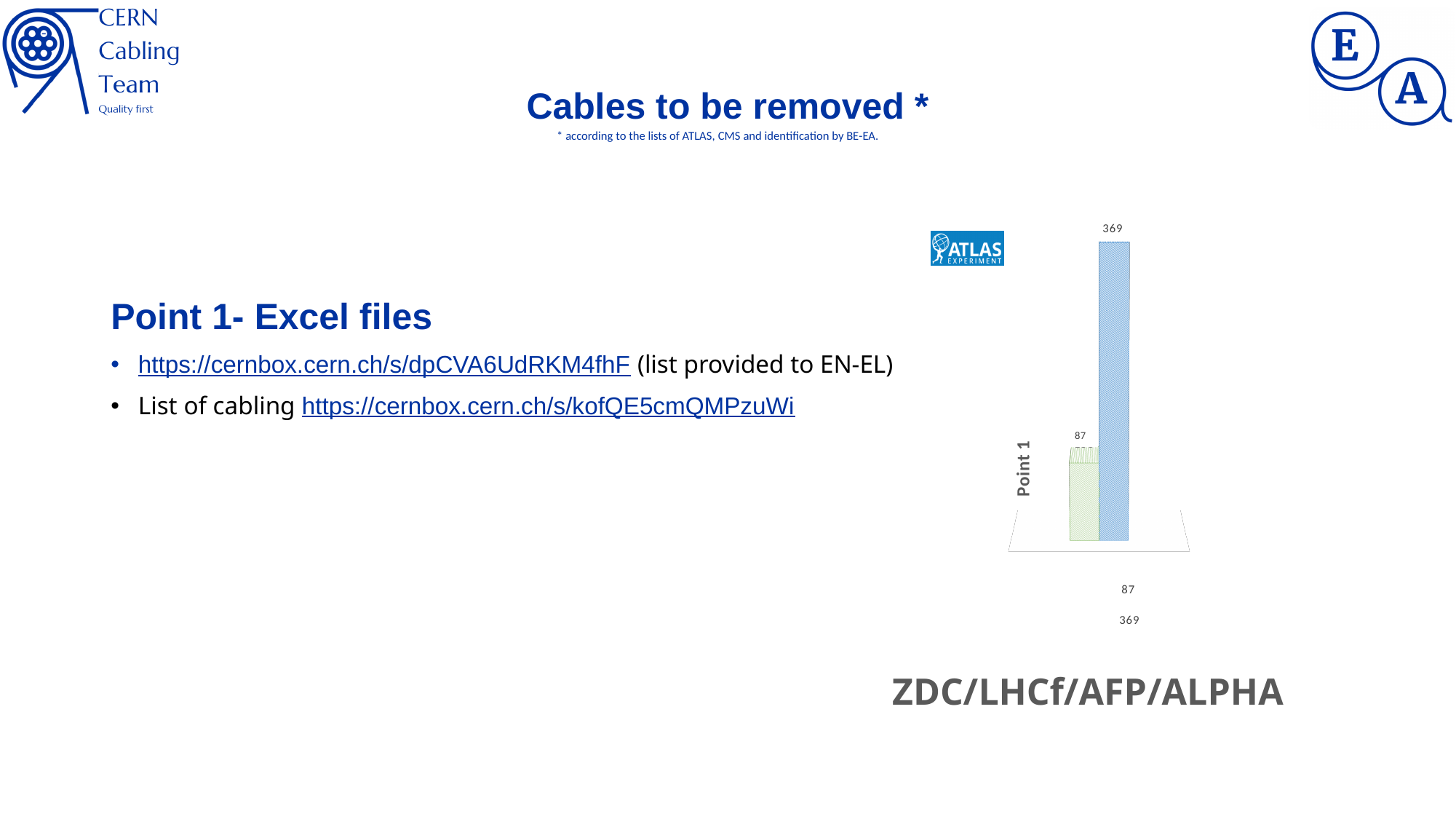
What is the difference between the two values shown for Point 1 (369 and 87)? 282 How many entries does the chart's legend list? 2 What kind of chart is shown on the slide? bar chart What is the name of the single category on the chart's axis? Point 1 What value is labelled on the shorter green bar for Point 1? 87 How many categories are shown on the chart's axis? 1 What value is labelled on the taller blue bar for Point 1? 369 What is the lowest value labelled on the chart? 87 Which bar is higher for Point 1, the green bar or the blue bar? the blue bar What text appears in large letters below the chart? ZDC/LHCf/AFP/ALPHA What is the highest value labelled on the chart? 369